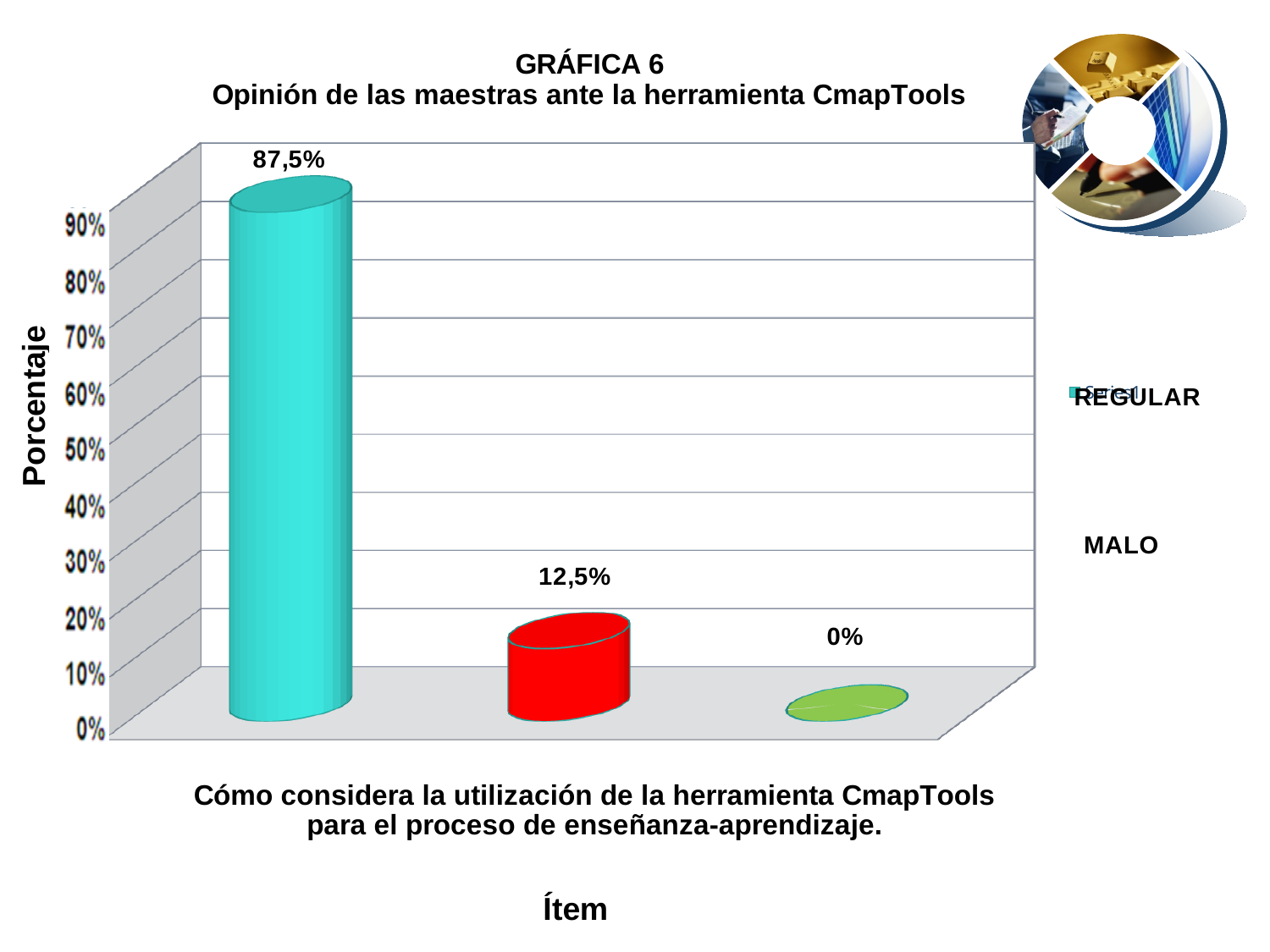
Is the value of the cyan bar on the left greater or less than 80%? greater What value is labelled on the red bar in the middle? 12,5% What kind of chart is shown on the slide? bar chart What is the difference between the value of the cyan bar (87,5%) and the red bar (12,5%)? 75% How many bars are plotted in the chart? 3 What is the lowest value shown in the chart? 0% What value is labelled on the tall cyan bar on the left? 87,5% What is the label of the vertical axis? Porcentaje What value is labelled on the green bar on the right? 0% What is the title of the chart? GRÁFICA 6 Opinión de las maestras ante la herramienta CmapTools Which bar has the larger value, the cyan bar on the left or the red bar in the middle? the cyan bar on the left What is the highest value shown in the chart? 87,5%